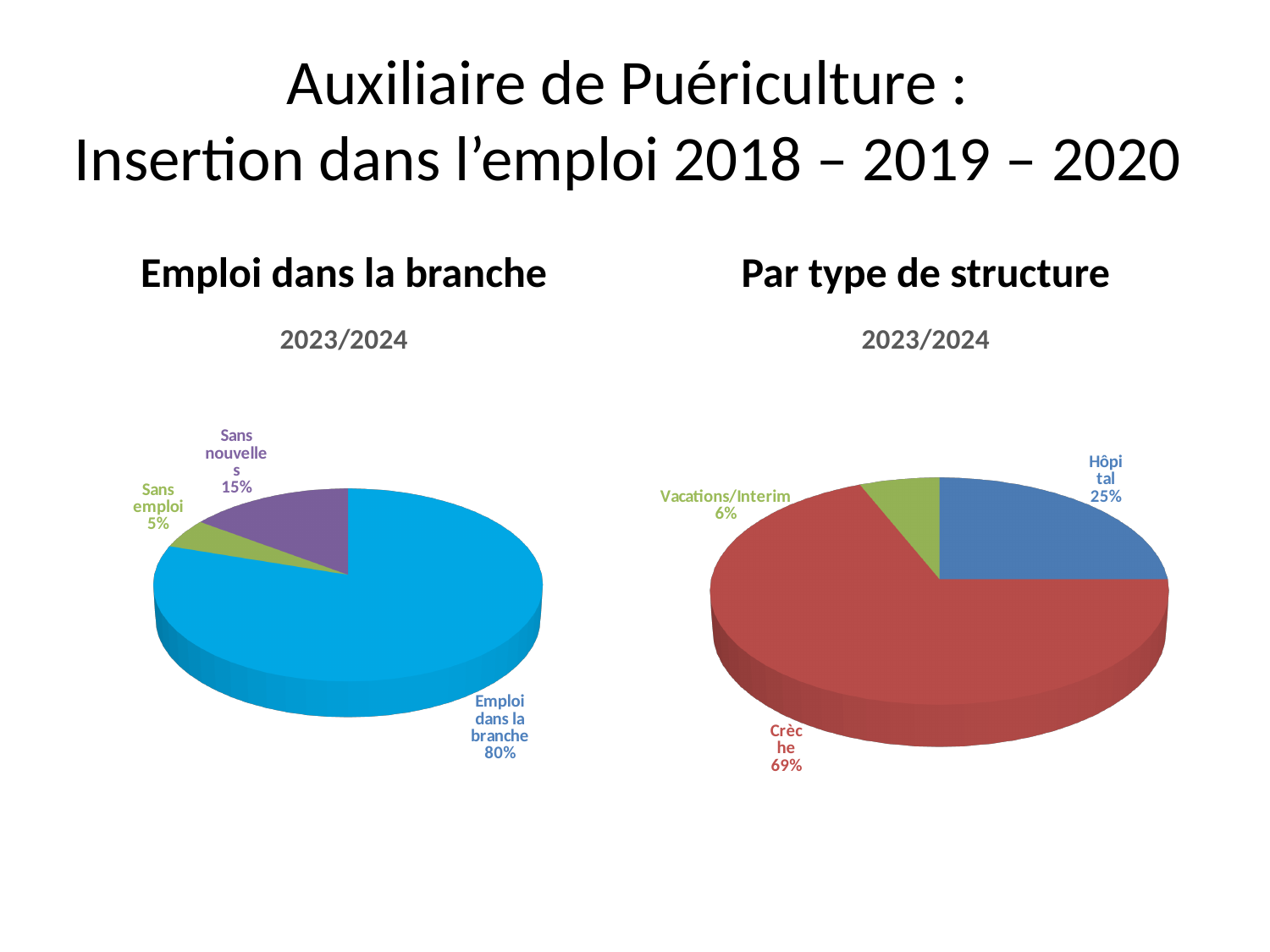
In the 'Emploi dans la branche' pie chart, what share is labelled for 'Sans emploi'? 5% What kind of chart is used on the right side of the slide, under 'Par type de structure'? Pie chart In the 'Par type de structure' pie chart, which is larger, 'Hôpital' or 'Vacations/Interim'? Hôpital In the 'Par type de structure' pie chart, what share is labelled for 'Crèche'? 69% In the 'Emploi dans la branche' pie chart, which slice is the largest? Emploi dans la branche In the 'Par type de structure' pie chart, what share is labelled for 'Vacations/Interim'? 6% In the 'Emploi dans la branche' pie chart, how many slices are there? 3 In the 'Par type de structure' pie chart, what is the difference in percentage points between 'Crèche' and 'Hôpital'? 44 In the 'Emploi dans la branche' pie chart, which slice is the smallest? Sans emploi